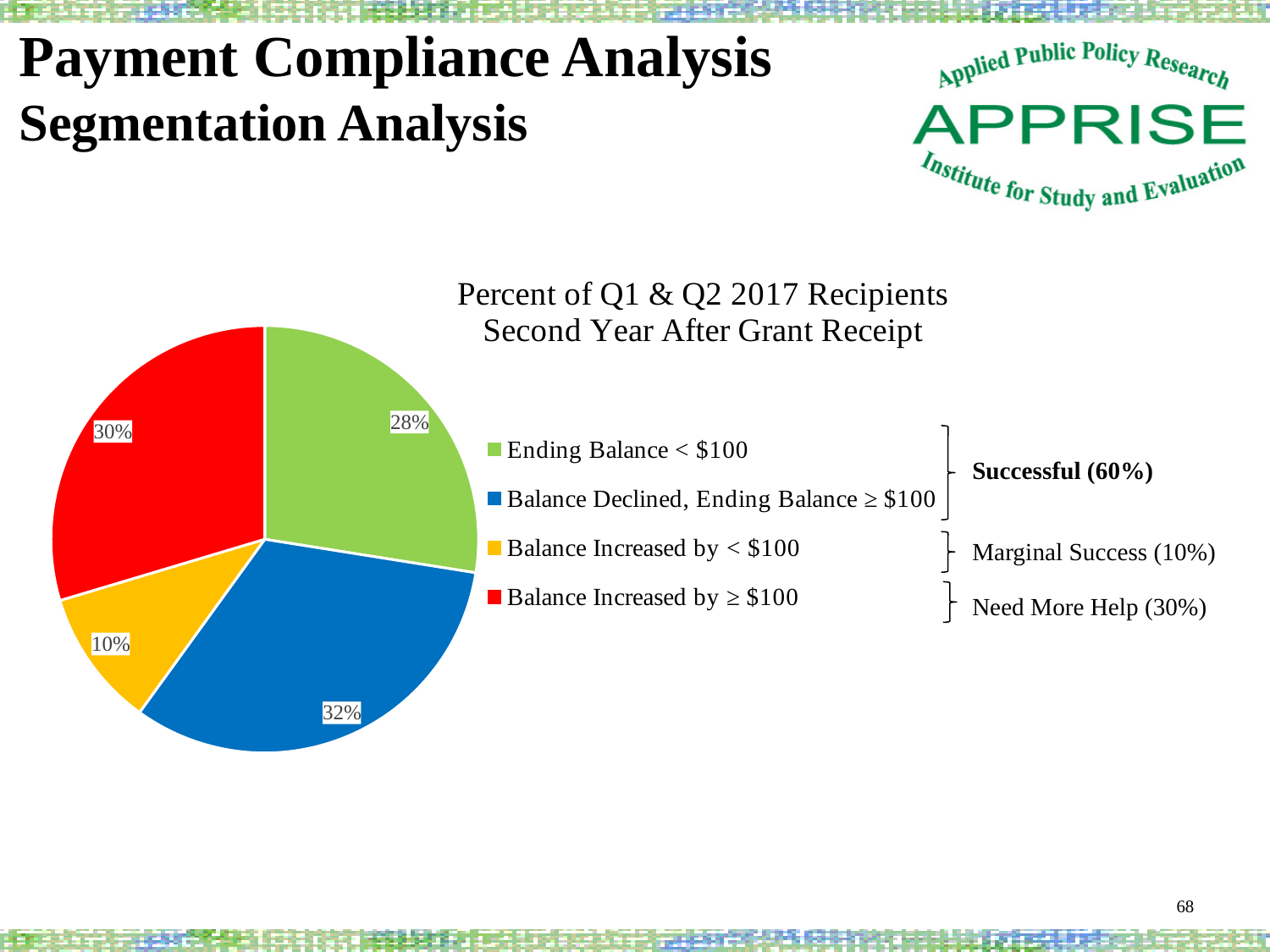
What percentage of recipients had an Ending Balance < $100? 28% What percentage of recipients had Balance Increased by < $100? 10% Which category has the smallest share of the pie? Balance Increased by < $100 What percentage of recipients had Balance Declined, Ending Balance ≥ $100? 32% Which is larger: the share for Balance Increased by ≥ $100 or the share for Ending Balance < $100? Balance Increased by ≥ $100 What percentage of recipients had Balance Increased by ≥ $100? 30% What type of chart is shown on the slide? Pie chart Which category has the largest share of the pie? Balance Declined, Ending Balance ≥ $100 What is the difference in percentage points between Balance Declined, Ending Balance ≥ $100 and Ending Balance < $100? 4 percentage points What is the title of the pie chart? Percent of Q1 & Q2 2017 Recipients Second Year After Grant Receipt What colour represents Balance Increased by < $100 in the pie chart? Yellow How many categories does the pie chart show? 4